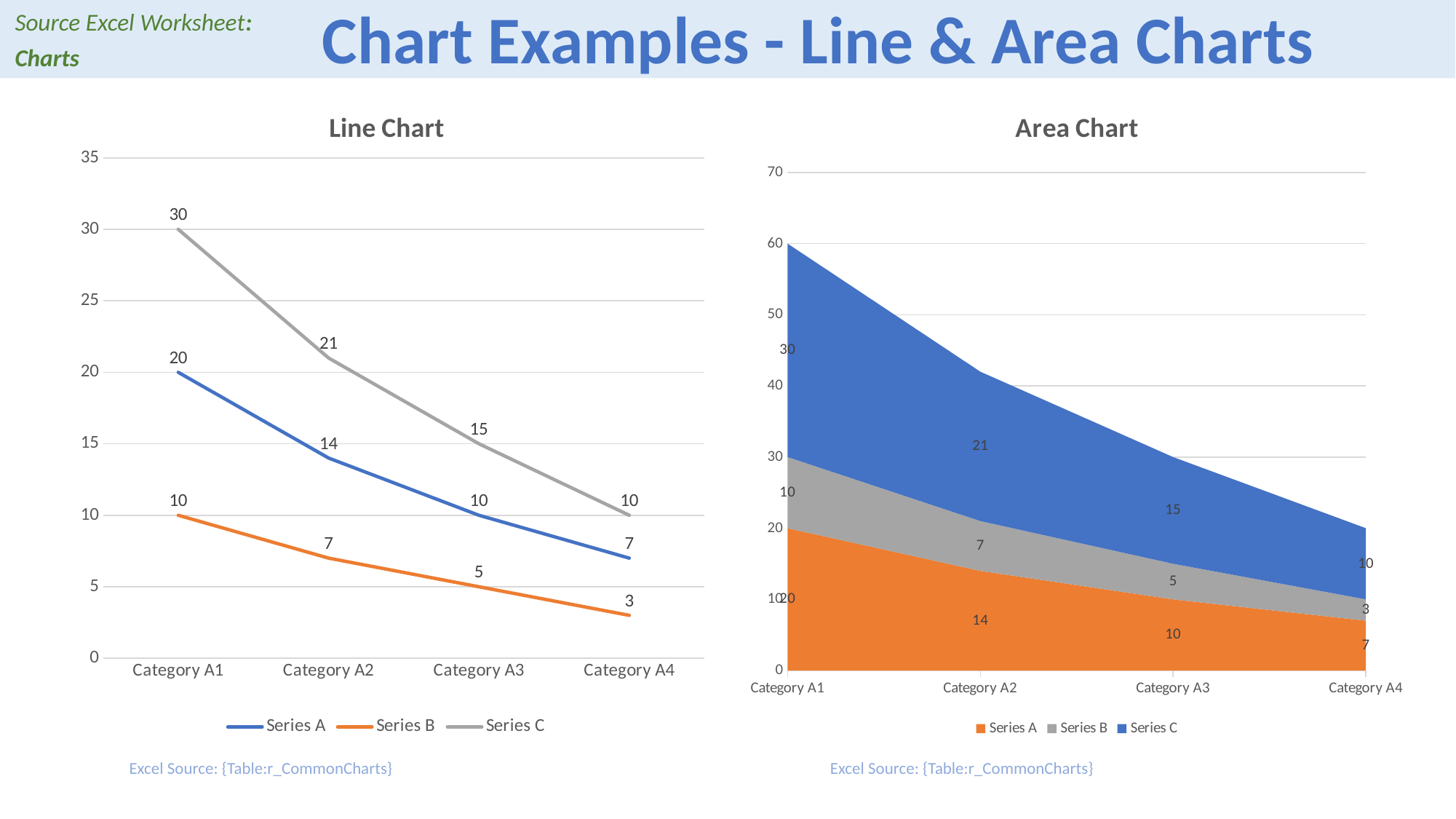
How many series does the legend of the Line Chart list? 3 In the Line Chart, which category has the highest value for Series B? Category A1 In the Line Chart, which category has the lowest value for Series C? Category A4 How many categories are shown on the x axis of the Area Chart? 4 In the Line Chart, what is the value of Series A at Category A4? 7 In the Area Chart, what is the total stacked value at Category A2? 42 In the Line Chart, which is larger at Category A3: Series A or Series B? Series A In the Area Chart, what is the value of Series B at Category A3? 5 What kind of chart is the chart on the right of the slide? area chart In the Line Chart, what is the value of Series C at Category A2? 21 In the Line Chart, do the values of Series A rise or fall from Category A1 to Category A4? fall In the Line Chart, what is the difference between Series C and Series A at Category A1? 10